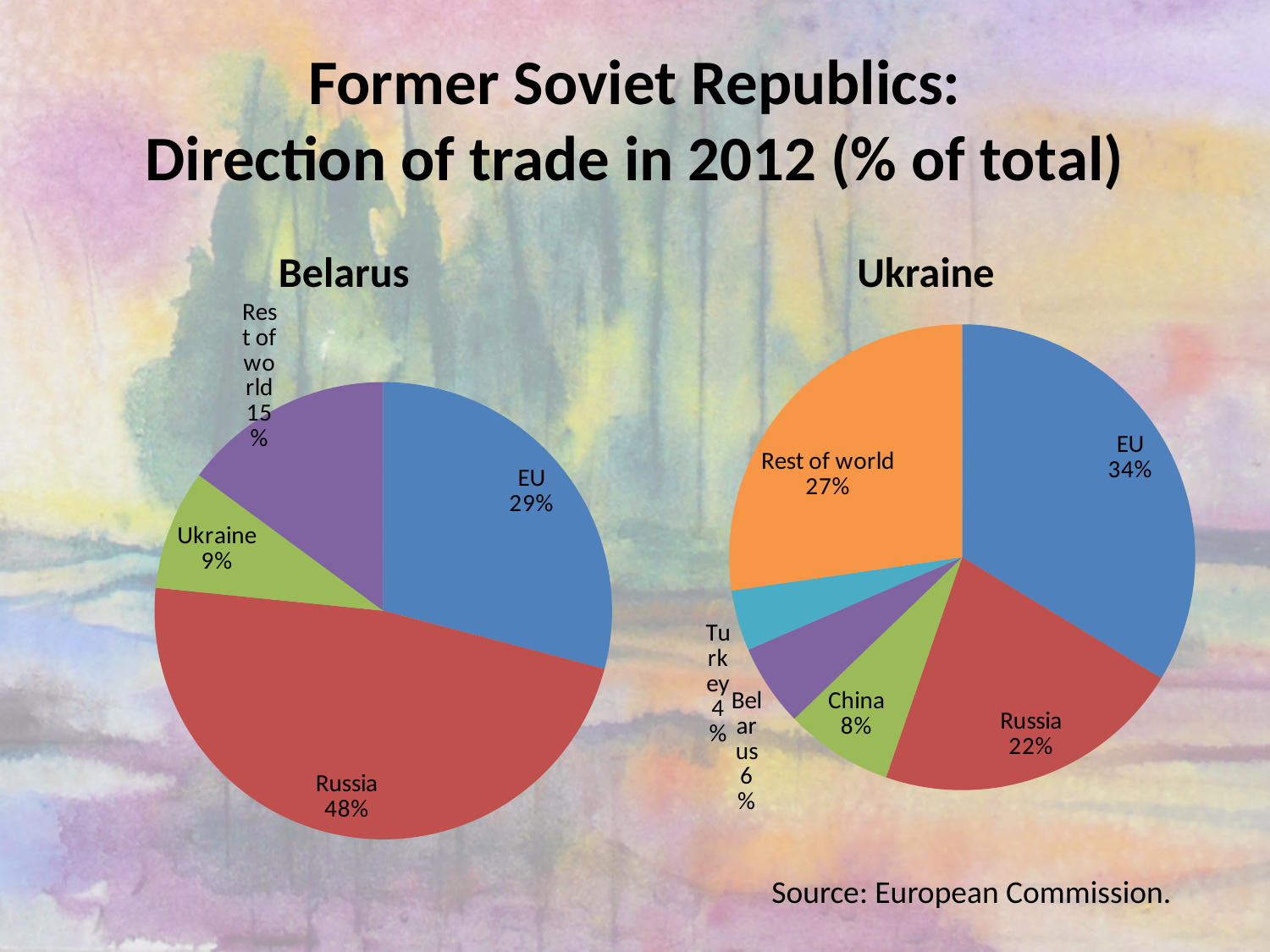
What type of chart is used for Belarus? Pie chart In the Ukraine chart, what is the difference between the EU share and the Russia share? 12% How many slices does the Belarus chart have? 4 In the Belarus chart, what is the difference between the Russia share and the EU share? 19% In the Ukraine chart, what share of trade goes to China? 8% In the Belarus chart, what share of trade goes to Russia? 48% In the Belarus chart, which trading partner has the smallest share? Ukraine How many slices does the Ukraine chart have? 6 In the Ukraine chart, which trading partner has the smallest share? Turkey In the Belarus chart, which trading partner has the largest share? Russia In the Ukraine chart, which is larger, the share for Rest of world or the share for Russia? Rest of world In the Ukraine chart, what share of trade goes to the EU? 34%